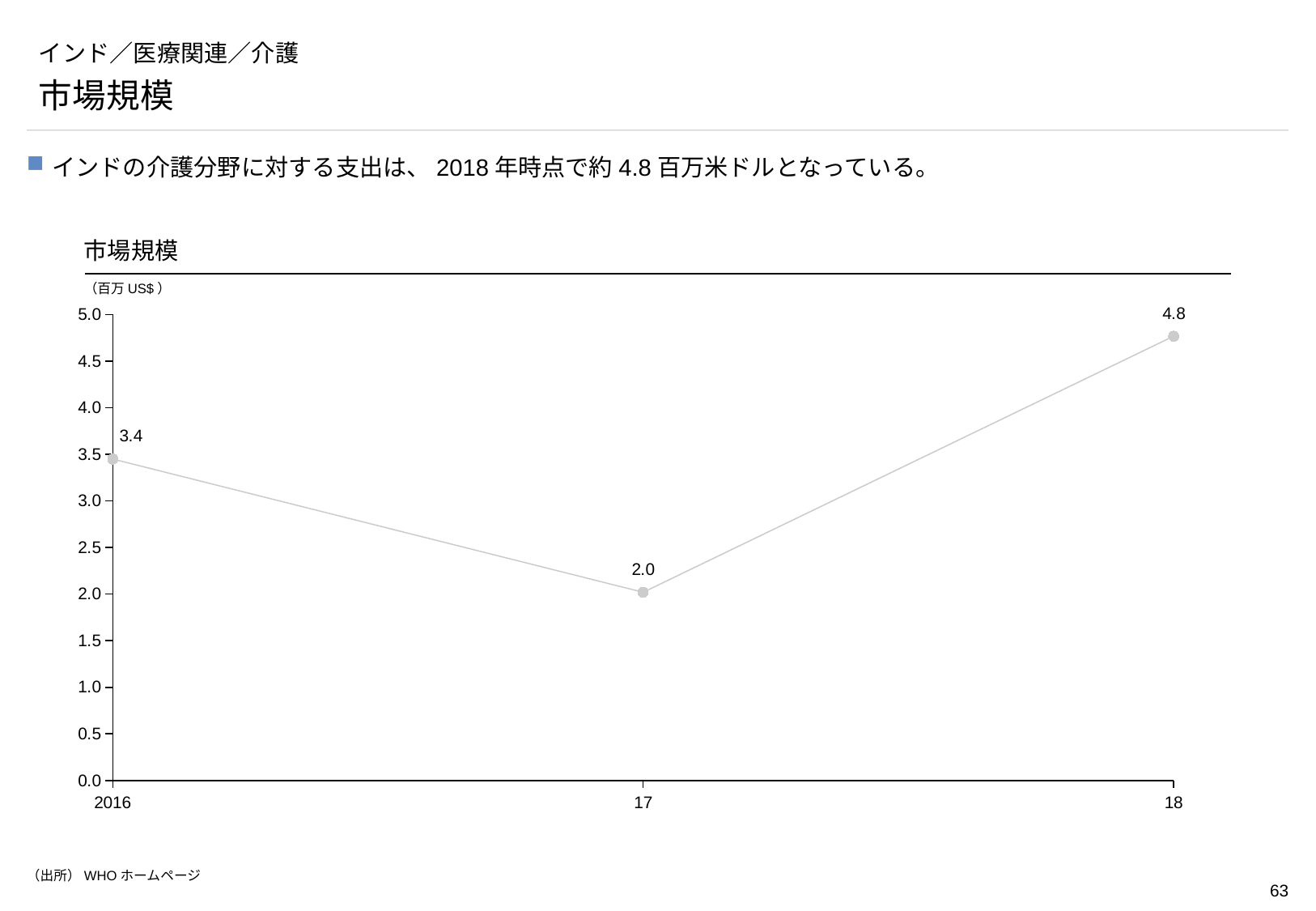
What is the market size value for 18? 4.8 How many data points are plotted on the chart? 3 What is the difference between the values for 18 and 2016? 1.4 What is the difference between the values for 2016 and 17? 1.4 Which year has the lowest market size value? 17 Is the value for 18 greater or less than 4.0? greater What is the market size value for 2016? 3.4 What kind of chart is shown on the slide? line chart What unit is shown for the chart's values? 百万 US$ Which is larger, the value for 2016 or the value for 17? 2016 Which year has the highest market size value? 18 What is the market size value for 17? 2.0